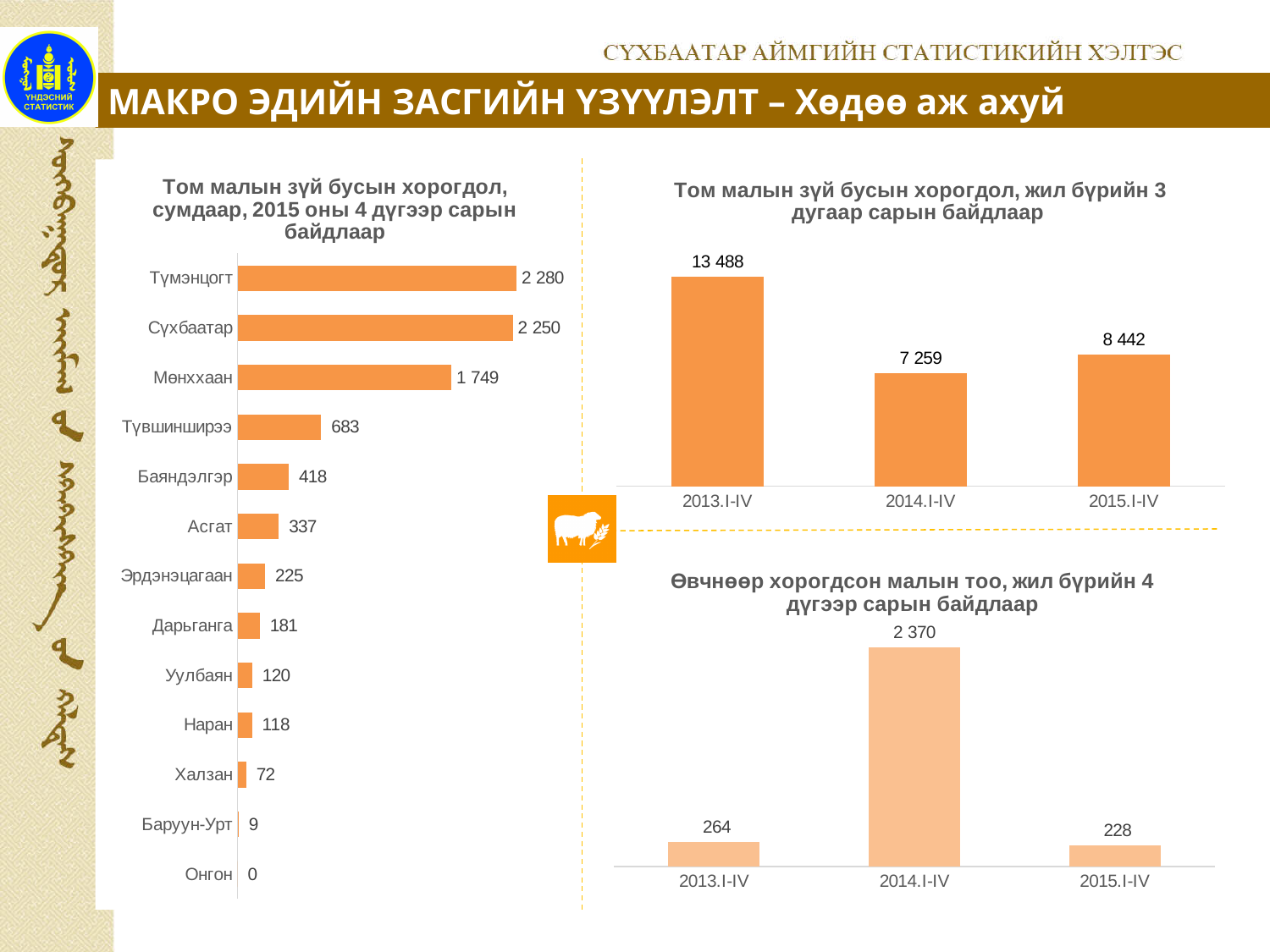
In the left chart (Том малын зүй бусын хорогдол, сумдаар), which is larger, Баяндэлгэр or Асгат? Баяндэлгэр In the bottom right chart (Өвчнөөр хорогдсон малын тоо), what is the value for 2014.I-IV? 2 370 In the bottom right chart (Өвчнөөр хорогдсон малын тоо), which year has the lowest value? 2015.I-IV In the top right chart (Том малын зүй бусын хорогдол, жил бүрийн 3 дугаар сарын байдлаар), what is the value for 2014.I-IV? 7 259 In the top right chart (Том малын зүй бусын хорогдол, жил бүрийн 3 дугаар сарын байдлаар), what is the difference between 2013.I-IV and 2015.I-IV? 5 046 In the left chart (Том малын зүй бусын хорогдол, сумдаар), how many categories are shown? 13 In the left chart (Том малын зүй бусын хорогдол, сумдаар), which category has the lowest value? Онгон In the top right chart (Том малын зүй бусын хорогдол, жил бүрийн 3 дугаар сарын байдлаар), which year has the highest value? 2013.I-IV In the left chart (Том малын зүй бусын хорогдол, сумдаар), which category has the highest value? Түмэнцогт What type of chart is the left chart (Том малын зүй бусын хорогдол, сумдаар)? bar chart In the left chart (Том малын зүй бусын хорогдол, сумдаар), what is the difference between Түмэнцогт and Сүхбаатар? 30 In the left chart (Том малын зүй бусын хорогдол, сумдаар), what is the value for Мөнххаан? 1 749